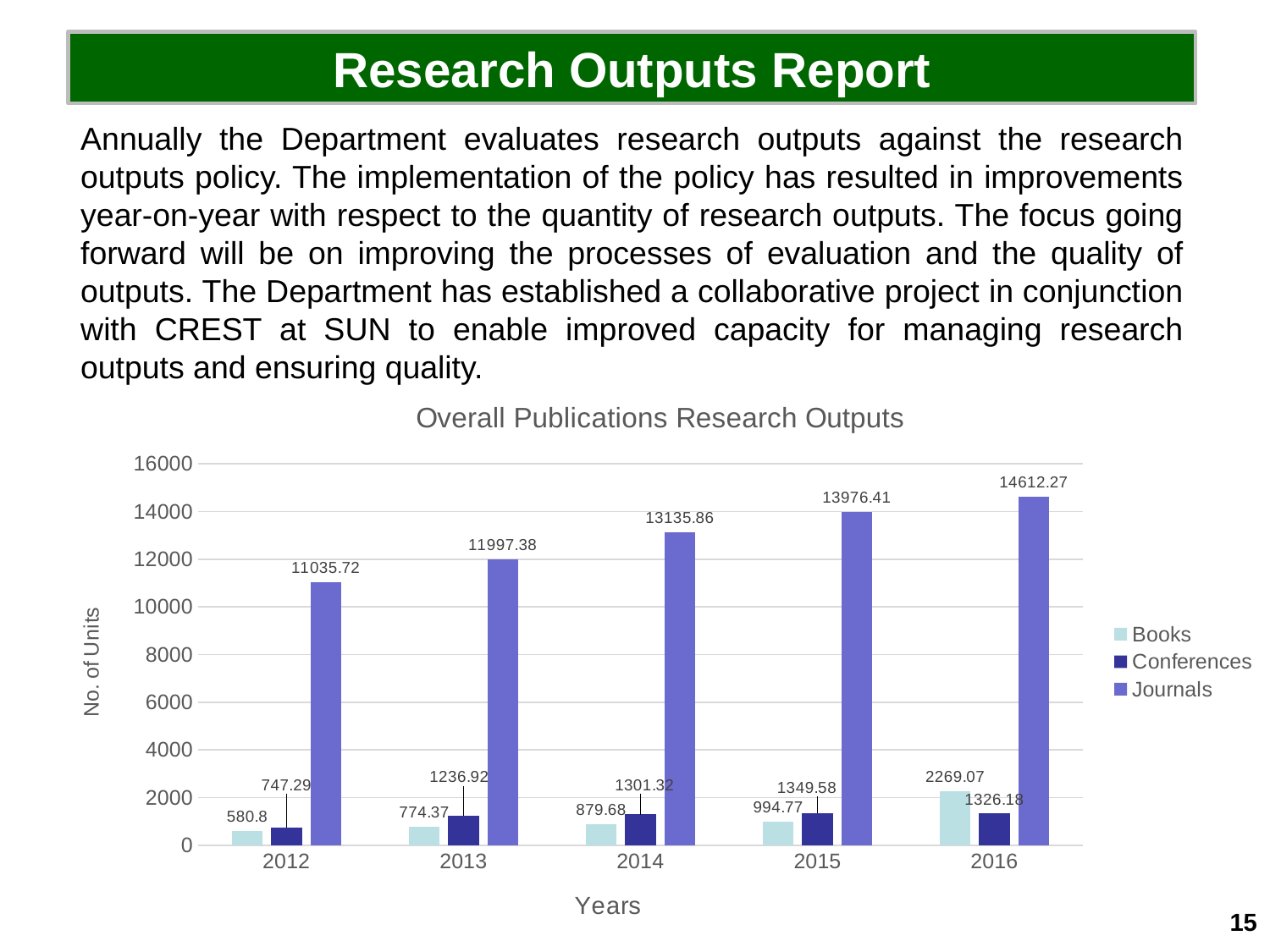
How many years are shown on the x axis? 5 What is the value for Conferences in 2014? 1301.32 Do the Journals values rise or fall from 2012 to 2016? Rise What is the difference between the Journals values for 2016 and 2015? 635.86 How many series does the legend list? 3 What is the value for Journals in 2016? 14612.27 What is the value for Books in 2012? 580.8 Is the value for Journals in 2012 greater or less than 10000? greater Which year has the lowest value for Books? 2012 Which year has the highest value for Journals? 2016 What kind of chart is shown on the slide? Bar chart Which is larger, Books in 2016 or Conferences in 2016? Books in 2016